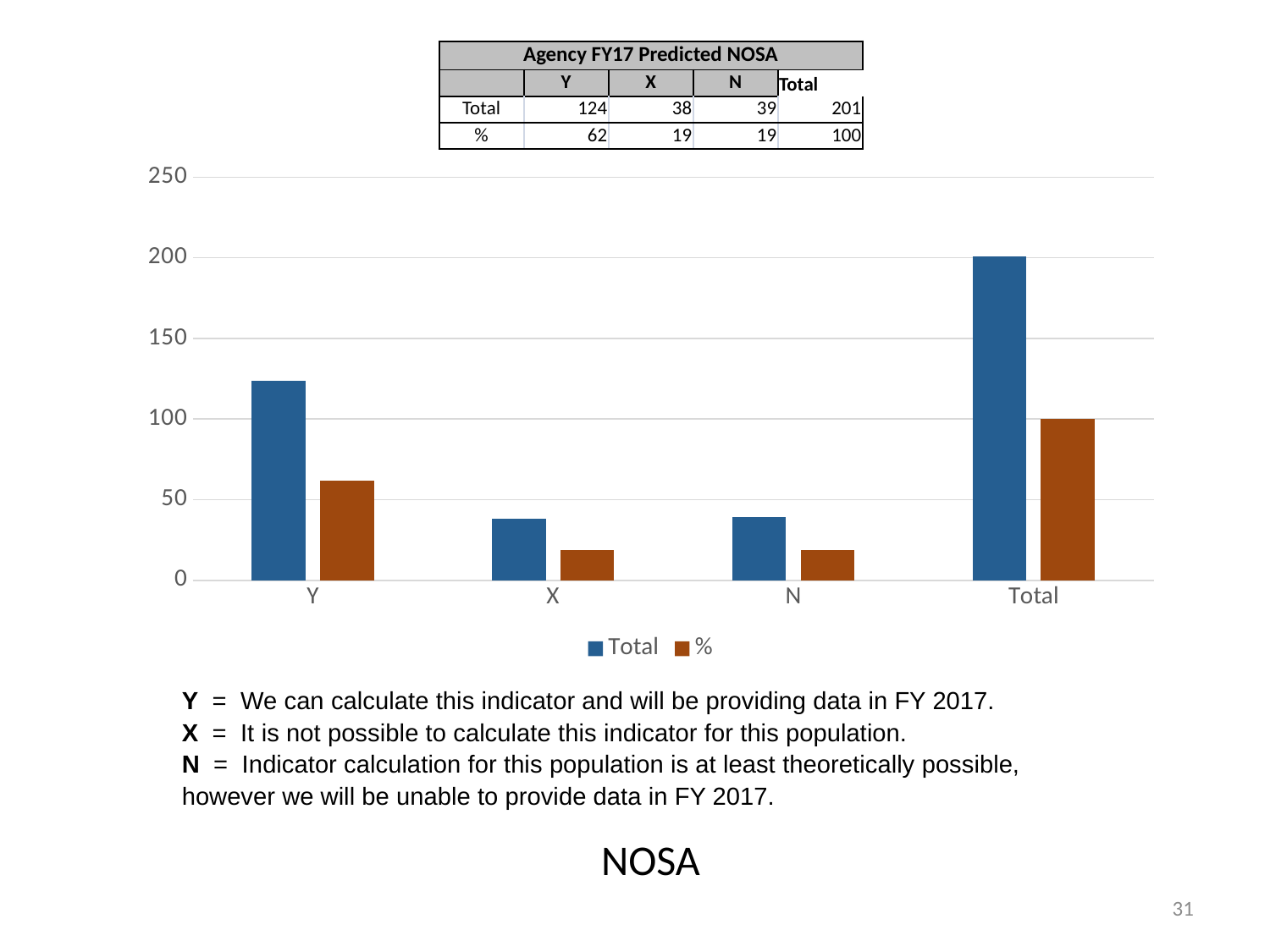
Is the Total value for category Y greater or less than 100? greater What is the difference between the Total value for Y and the Total value for X? 86 What is the Total value for category Y? 124 Which category has the highest Total value? Total What is the % value for category X? 19 How many categories are shown on the x axis of the chart? 4 Is the Total value for category N greater or less than 50? less Which category has the highest % value? Total How many series does the chart legend list? 2 Which is larger, the Total value for Y or the Total value for X? Y What is the Total value for the Total category? 201 What kind of chart is shown on the slide? bar chart